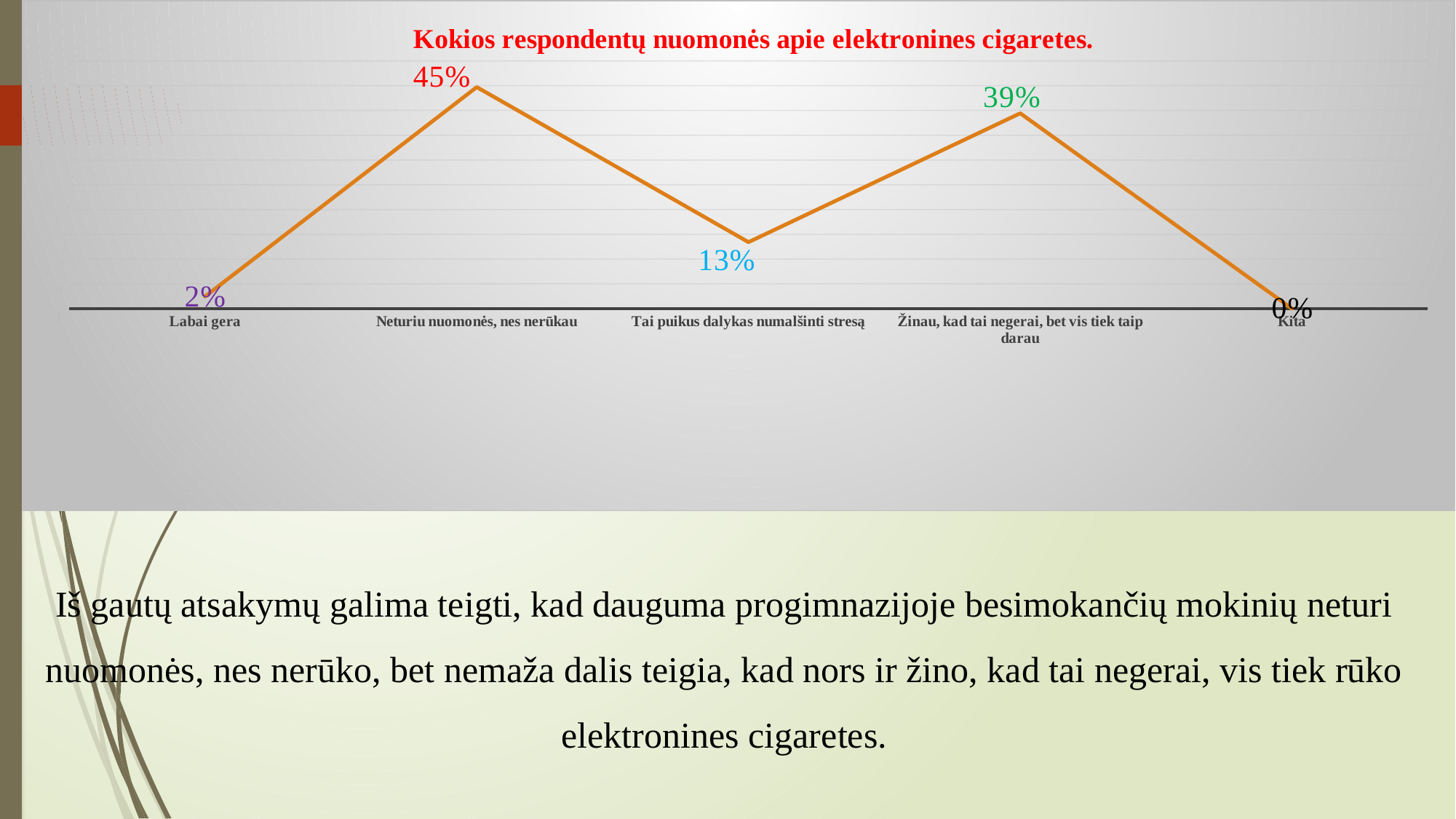
What is the value for "Kita"? 0% What is the value for "Žinau, kad tai negerai, bet vis tiek taip darau"? 39% What is the value for "Labai gera"? 2% What is the title of the chart? Kokios respondentų nuomonės apie elektronines cigaretes. Which category has the highest value? Neturiu nuomonės, nes nerūkau Which is larger: the value for "Tai puikus dalykas numalšinti stresą" or the value for "Labai gera"? Tai puikus dalykas numalšinti stresą What is the value for "Tai puikus dalykas numalšinti stresą"? 13% How many categories are plotted on the chart? 5 Which category has the lowest value? Kita What kind of chart is shown on the slide? Line chart What is the difference between the values for "Neturiu nuomonės, nes nerūkau" and "Žinau, kad tai negerai, bet vis tiek taip darau"? 6% What is the value for "Neturiu nuomonės, nes nerūkau"? 45%